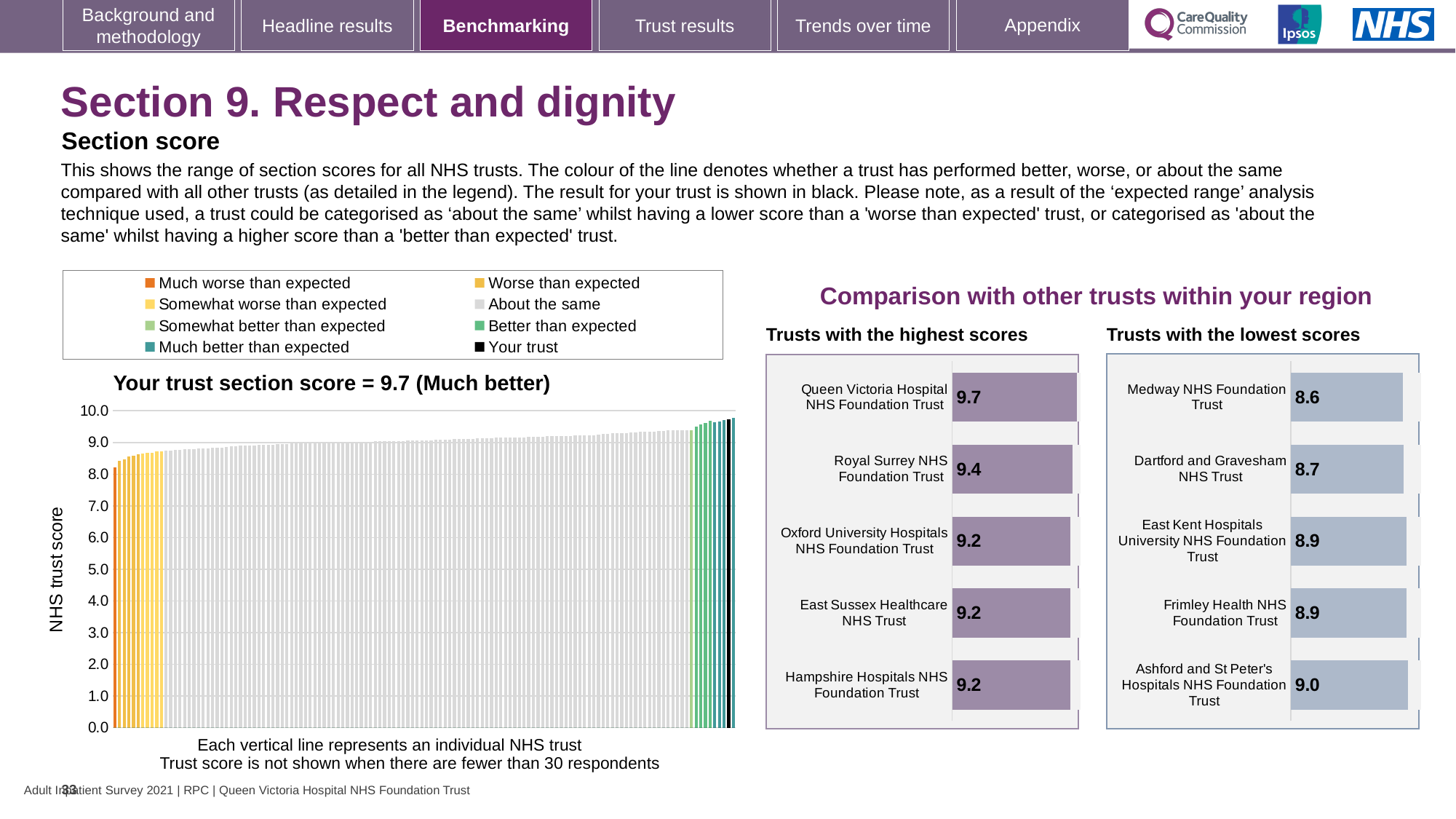
In the 'Trusts with the highest scores' chart, what is the score for Royal Surrey NHS Foundation Trust? 9.4 In the 'Trusts with the highest scores' chart, how many trusts are shown? 5 In the 'Your trust section score' chart, do the trust scores rise or fall from left to right along the x axis? rise In the 'Trusts with the highest scores' chart, which trust has the highest score? Queen Victoria Hospital NHS Foundation Trust In the 'Trusts with the lowest scores' chart, which trust has the lowest score? Medway NHS Foundation Trust In the 'Your trust section score' chart, is the value of the lowest-scoring trust greater or less than 7.0? greater In the 'Trusts with the lowest scores' chart, what is the score for Ashford and St Peter's Hospitals NHS Foundation Trust? 9.0 In the 'Your trust section score' chart, what is the section score for your trust? 9.7 In the 'Trusts with the lowest scores' chart, which has the larger score, Medway NHS Foundation Trust or Dartford and Gravesham NHS Trust? Dartford and Gravesham NHS Trust What kind of chart is the 'Your trust section score' chart? bar chart In the 'Trusts with the highest scores' chart, what is the difference between the scores of Queen Victoria Hospital NHS Foundation Trust and Royal Surrey NHS Foundation Trust? 0.3 In the 'Your trust section score' chart, how many categories does the legend list? 8